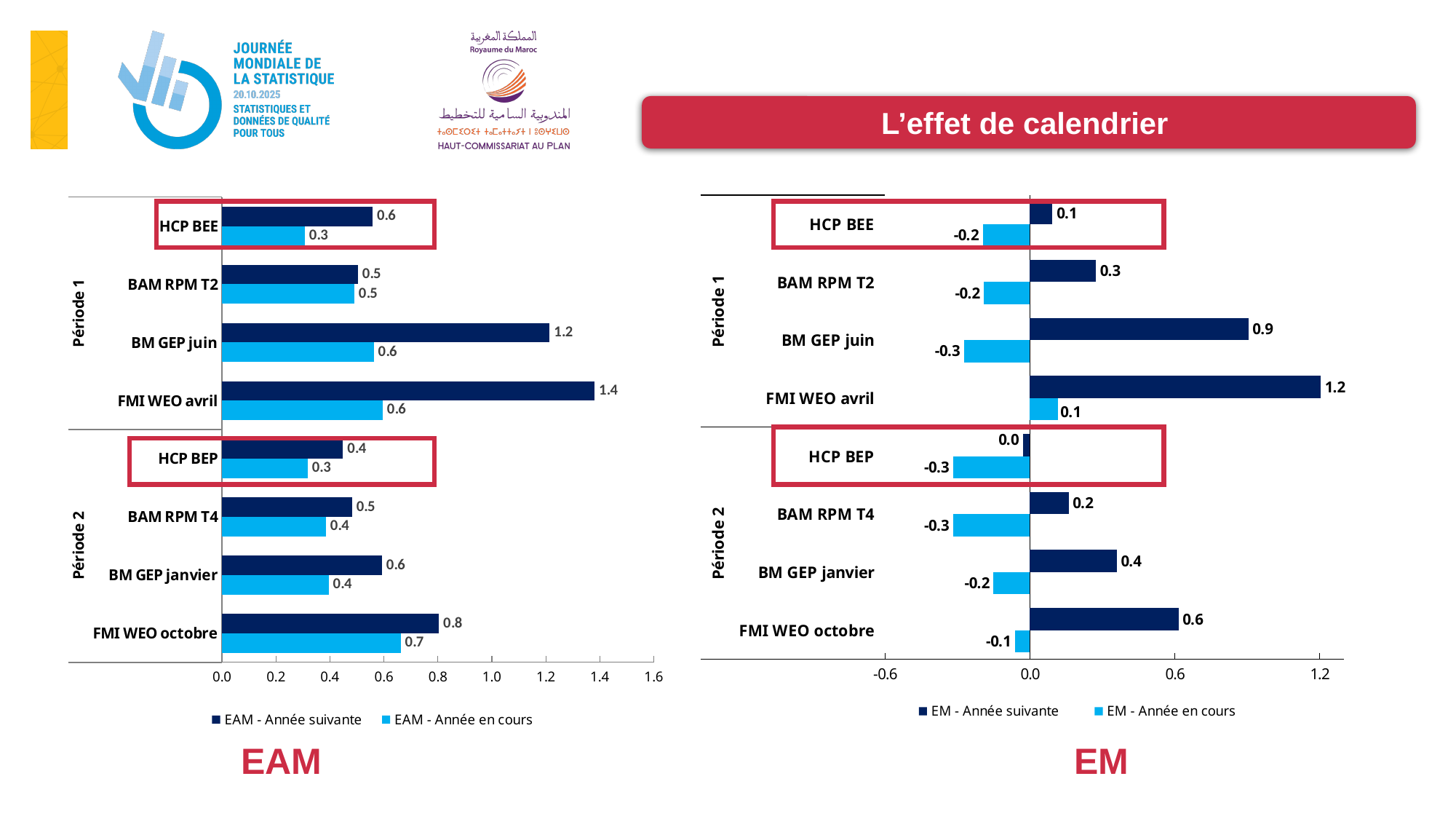
In the EAM chart, which category has the highest EAM - Année suivante value? FMI WEO avril In the EM chart, what is the value of EM - Année suivante for HCP BEP? 0.0 In the EM chart, what is the difference between the EM - Année suivante value for FMI WEO avril and the EM - Année suivante value for FMI WEO octobre? 0.6 In the EAM chart, what is the difference between the EAM - Année suivante and EAM - Année en cours values for BM GEP juin? 0.6 In the EAM chart, what is the value of EAM - Année en cours for FMI WEO octobre? 0.7 In the EM chart, which category has the highest EM - Année suivante value? FMI WEO avril In the EM chart, which is larger for BAM RPM T2: EM - Année suivante or EM - Année en cours? EM - Année suivante What type of chart is the EAM chart? Bar chart In the EAM chart, what is the value of EAM - Année suivante for FMI WEO avril? 1.4 In the EM chart, what is the value of EM - Année en cours for BM GEP juin? -0.3 How many series does the legend of the EM chart list? 2 In the EAM chart, how many categories are plotted? 8